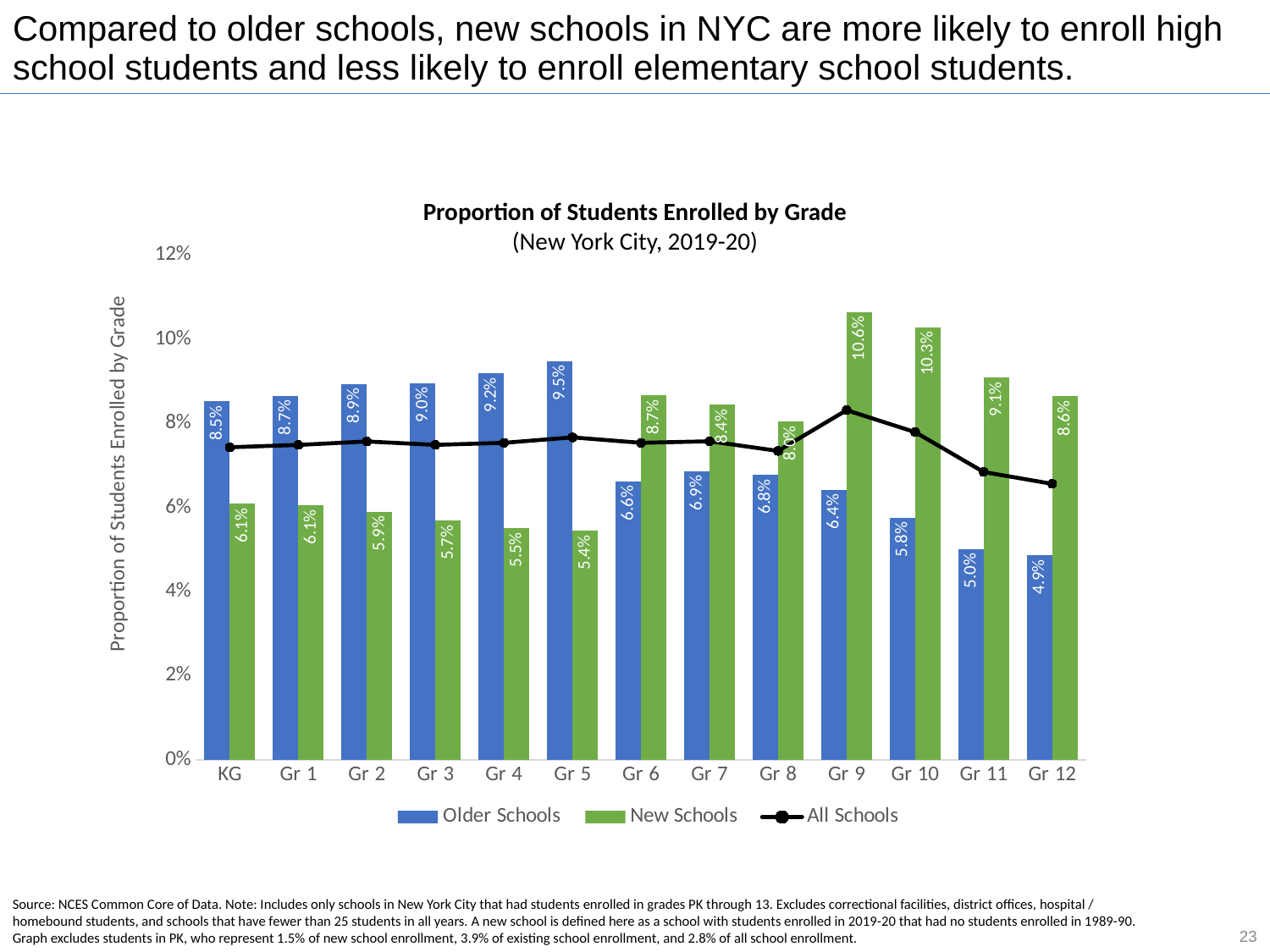
Is the All Schools value at Gr 12 greater or less than 8%? less What is the value for New Schools at Gr 9? 10.6% What is the difference between the New Schools and Older Schools values at Gr 9? 4.2 percentage points How many grade categories are shown on the x axis? 13 Which grade has the lowest value for New Schools? Gr 5 What is the value for Older Schools at Gr 5? 9.5% Do the Older Schools values rise or fall from Gr 9 to Gr 12? fall Which grade has the highest value for New Schools? Gr 9 What kind of chart is this? Bar chart with a line How many series does the legend list? 3 At KG, which is larger: Older Schools or New Schools? Older Schools What is the value for New Schools at Gr 3? 5.7%